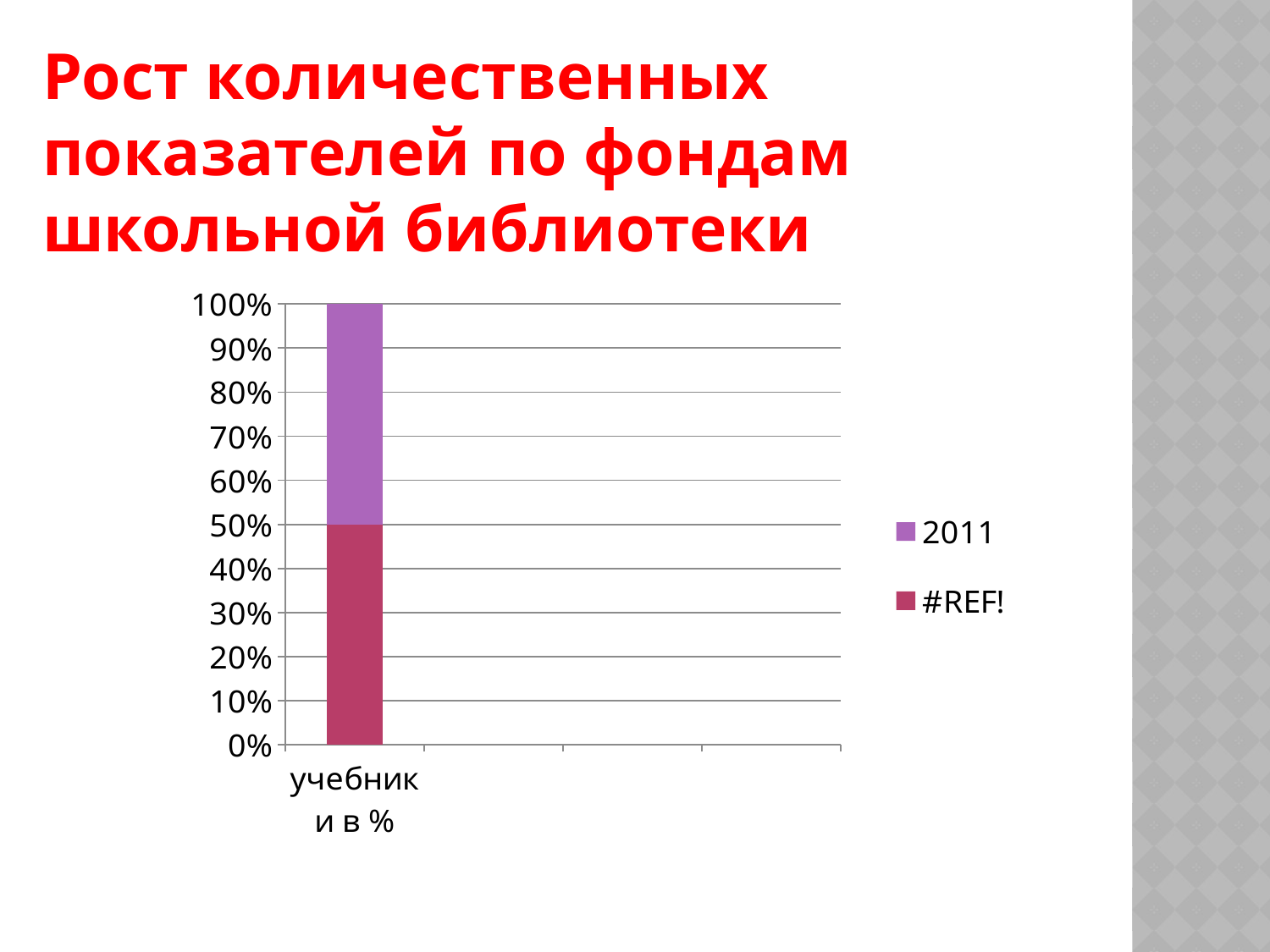
How many series does the chart legend list? 2 How many categories are plotted on the x axis of the chart? 1 Which series is drawn at the bottom of the stacked bar? #REF! At what percentage does the boundary between the #REF! segment and the 2011 segment of the bar lie? 50% Is the top of the stacked bar for учебники в % greater or less than 90%? greater What is the highest value shown on the y axis of the chart? 100% What is the label of the single category on the x axis? учебники в % What is the total height of the stacked bar for учебники в %? 100% What kind of chart is shown on the slide? stacked bar chart Is the value of the #REF! segment for учебники в % greater or less than 60%? less